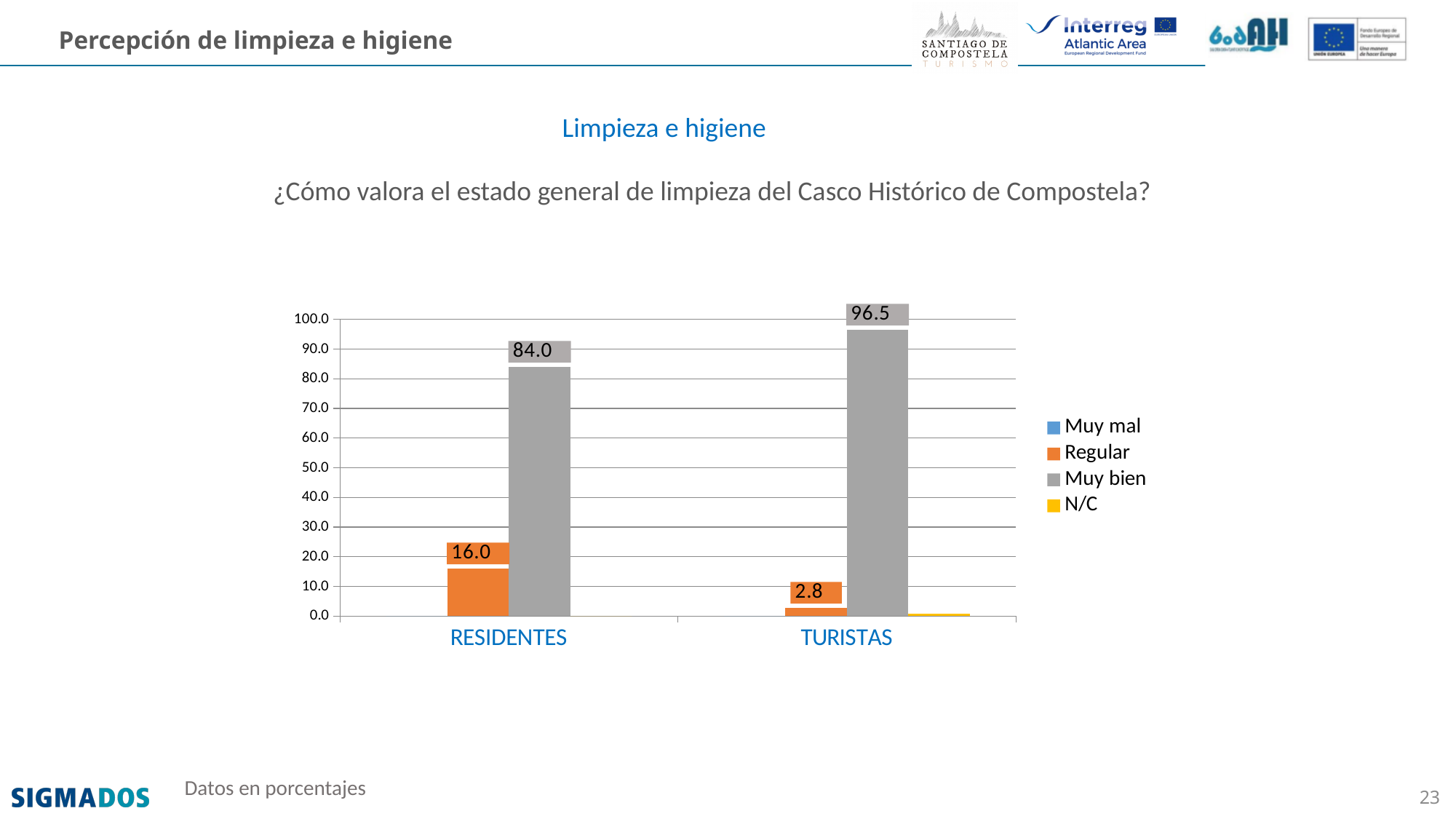
What is the value for Muy bien among TURISTAS? 96.5 What is the value for Muy bien among RESIDENTES? 84.0 What is the value for Regular among RESIDENTES? 16.0 Which legend entry is shown in orange? Regular Which group has the higher Regular value, RESIDENTES or TURISTAS? RESIDENTES What is the difference between the Regular values for RESIDENTES and TURISTAS? 13.2 How many groups are shown on the x axis? 2 What is the difference between the Muy bien values for TURISTAS and RESIDENTES? 12.5 What kind of chart is shown on the slide? Bar chart Which group has the higher Muy bien value, RESIDENTES or TURISTAS? TURISTAS How many series does the legend list? 4 What is the value for Regular among TURISTAS? 2.8